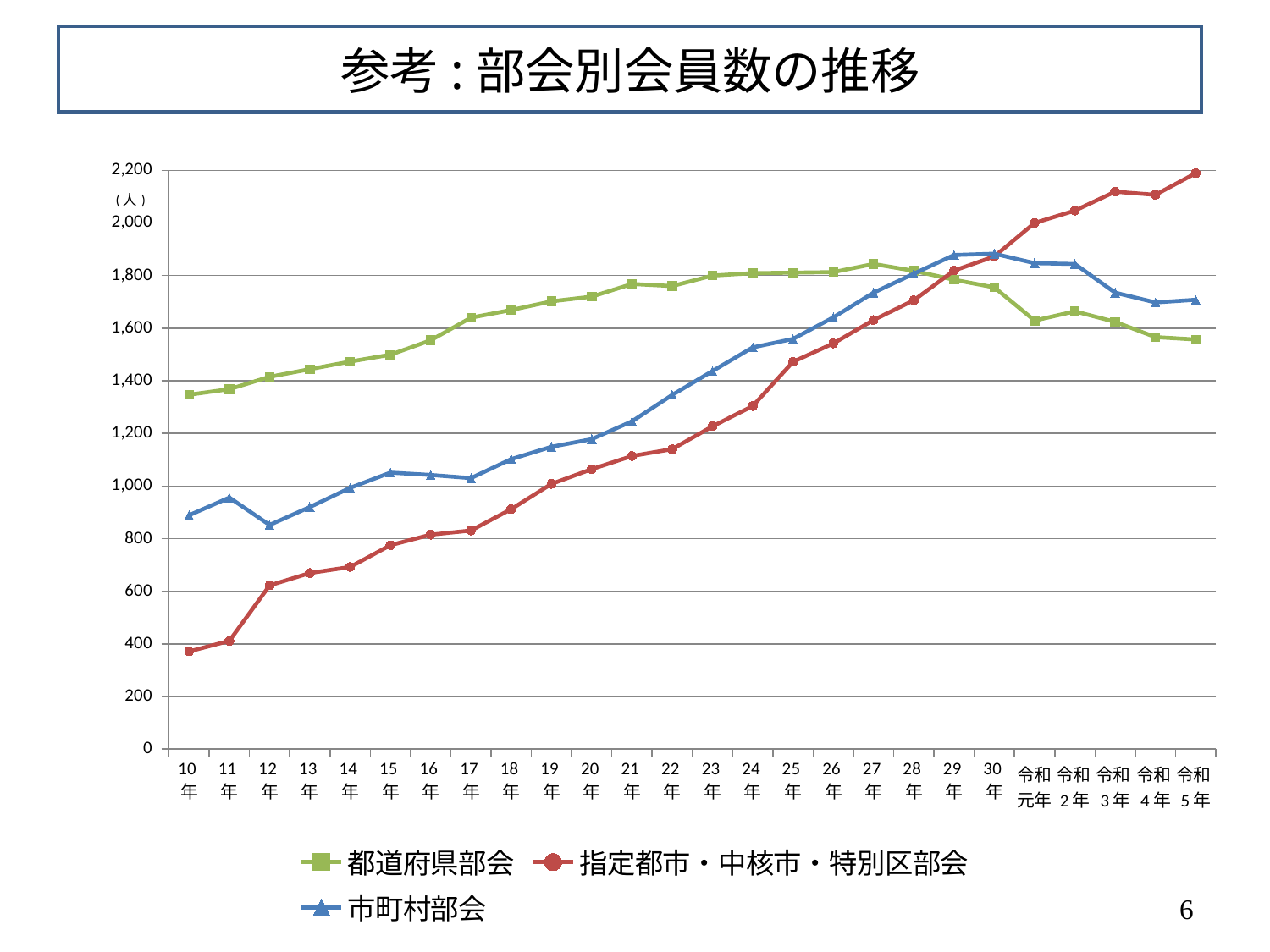
Is the value for 市町村部会 at 令和5年 greater or less than 1,600? greater Is the value for 指定都市・中核市・特別区部会 at 10年 greater or less than 400? less Which series has the lowest value at 10年? 指定都市・中核市・特別区部会 At 令和5年, which is larger: 指定都市・中核市・特別区部会 or 都道府県部会? 指定都市・中核市・特別区部会 Does the 指定都市・中核市・特別区部会 line generally rise or fall from 10年 to 令和5年? rise What kind of chart is shown on the slide? line chart What is the title of the chart? 参考：部会別会員数の推移 Is the value for 指定都市・中核市・特別区部会 at 令和5年 greater or less than 2,000? greater At 10年, which is larger: 都道府県部会 or 指定都市・中核市・特別区部会? 都道府県部会 How many points along the x axis does each line have? 26 How many series does the legend list? 3